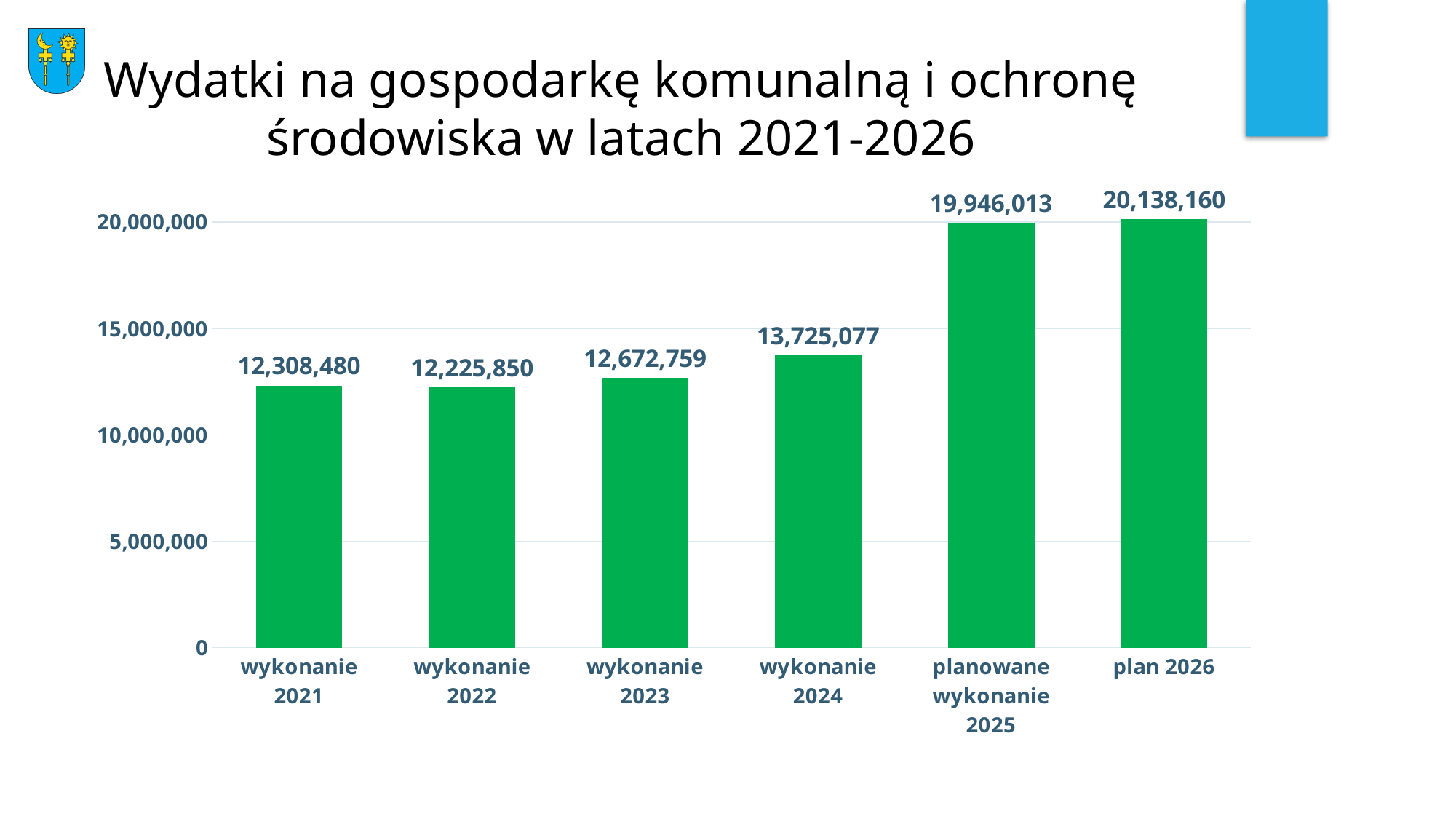
How many categories are shown on the x axis? 6 What is the difference between wykonanie 2024 and wykonanie 2023? 1,052,318 Is the value for wykonanie 2021 greater or less than 15,000,000? less What is the value for wykonanie 2022? 12,225,850 What kind of chart is shown on the slide? bar chart What is the value for planowane wykonanie 2025? 19,946,013 What is the value for plan 2026? 20,138,160 What is the difference between plan 2026 and planowane wykonanie 2025? 192,147 Which category has the lowest value? wykonanie 2022 Which is larger, wykonanie 2023 or wykonanie 2024? wykonanie 2024 What is the value for wykonanie 2024? 13,725,077 Which category has the highest value? plan 2026